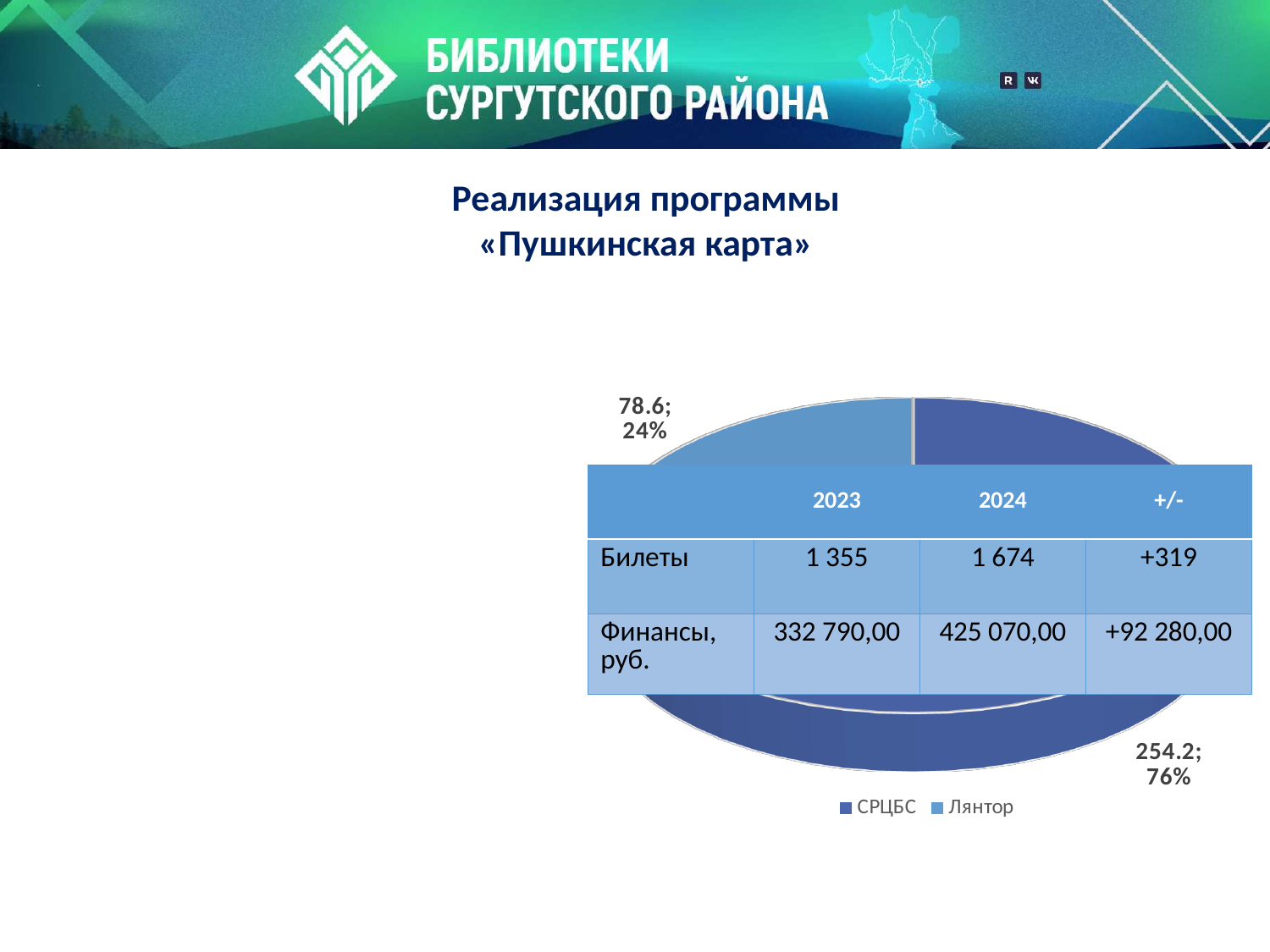
Which is larger in the pie chart, СРЦБС or Лянтор? СРЦБС Which slice of the pie chart is the smallest? Лянтор What share of the pie does СРЦБС account for? 76% What is the value shown for Лянтор in the pie chart? 78.6 How many entries does the pie chart's legend list? 2 What kind of chart is shown on the slide? pie chart What share of the pie does Лянтор account for? 24% How many slices does the pie chart have? 2 Which legend entry of the pie chart is shown in the lighter blue colour? Лянтор Which slice of the pie chart is the largest? СРЦБС What is the value shown for СРЦБС in the pie chart? 254.2 What is the difference between the СРЦБС and Лянтор values in the pie chart? 175.6